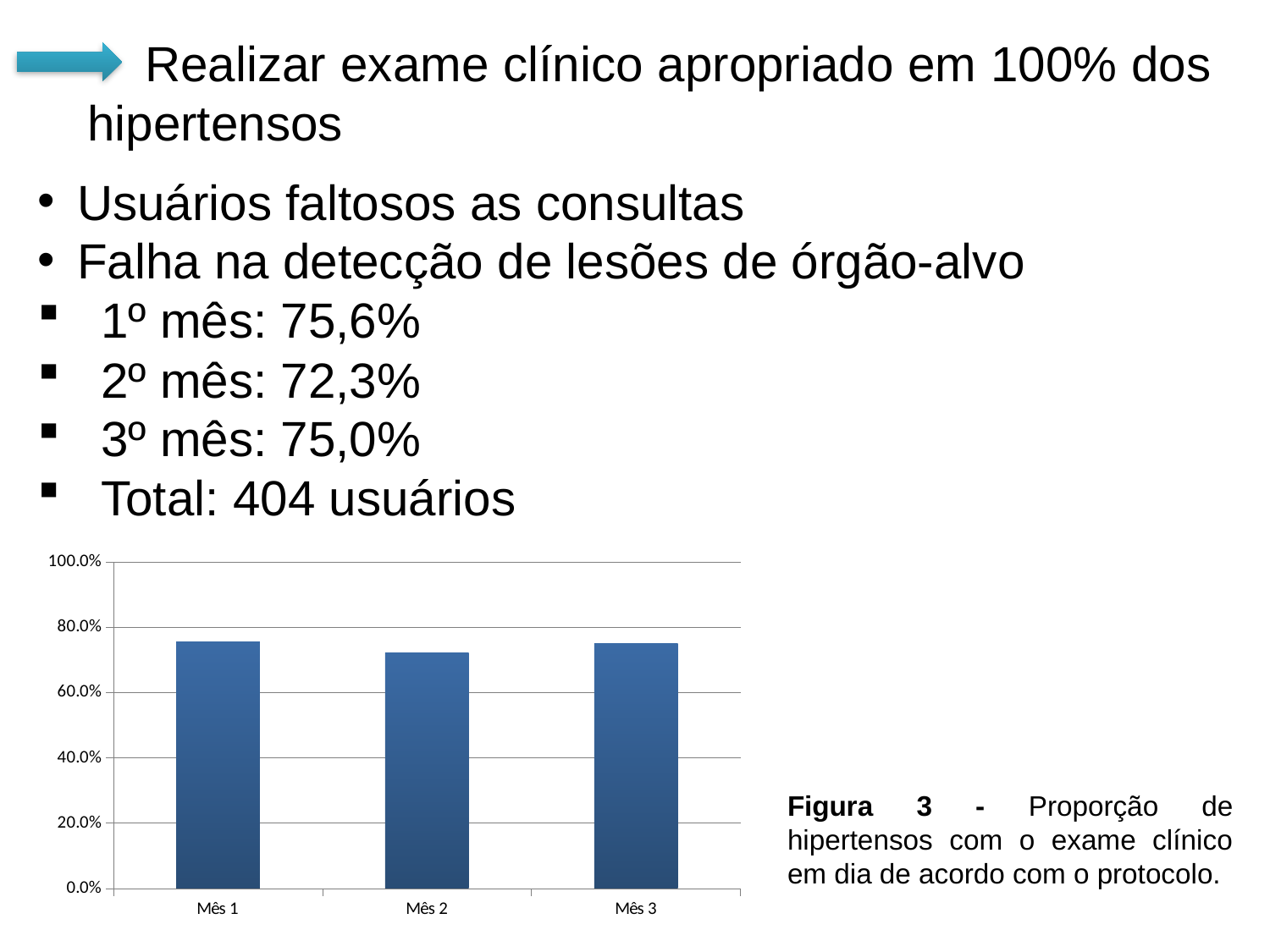
According to the slide, what is the proportion for Mês 3? 75,0% What is the highest value shown on the chart's vertical axis? 100.0% Is the value for Mês 2 greater or less than 80.0%? less How many months (categories) are plotted on the chart? 3 Which month has the lowest bar on the chart? Mês 2 What kind of chart is shown on the slide? bar chart What is the difference in percentage points between the values for Mês 1 and Mês 2? 3,3 According to the slide, what is the proportion for Mês 2? 72,3% According to the slide, what is the proportion of hypertensive patients with an up-to-date clinical exam in Mês 1? 75,6% Is the value for Mês 1 greater or less than 60.0%? greater What figure number does the caption assign to this chart? Figura 3 Which is larger, the value for Mês 1 or the value for Mês 2? Mês 1